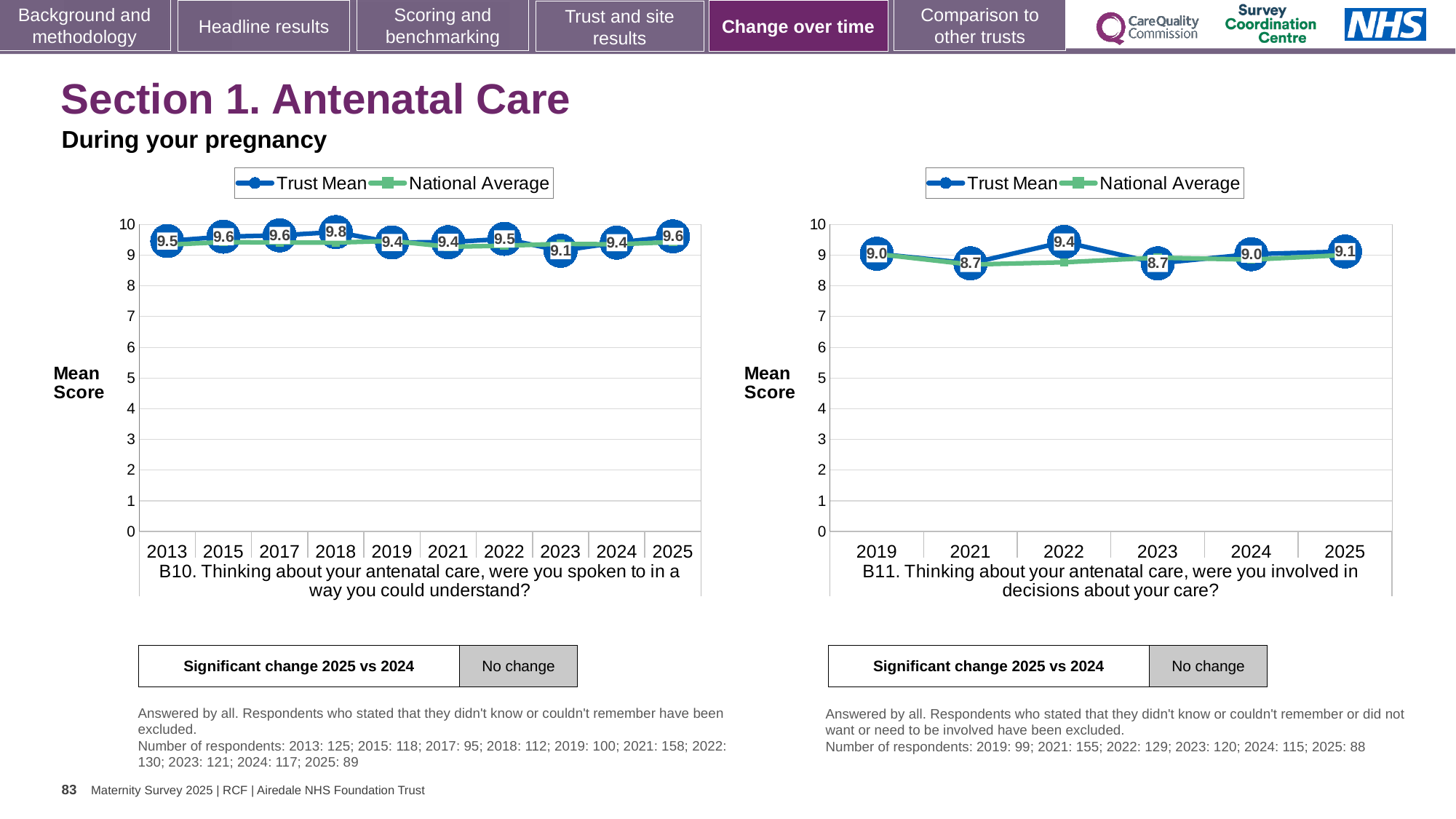
In the right chart (B11), is the Trust Mean for 2024 or 2025 larger? 2025 In the left chart (B10), what is the difference between the Trust Mean for 2018 and 2023? 0.7 In the right chart (B11), how many series does the legend list? 2 In the left chart (B10), what is the Trust Mean for 2023? 9.1 In the right chart (B11), what is the Trust Mean for 2025? 9.1 In the left chart (B10), what is the Trust Mean for 2018? 9.8 In the right chart (B11), which year has the highest Trust Mean? 2022 In the left chart (B10), how many years are shown on the x axis? 10 What type of chart is the left chart (B10)? Line chart In the left chart (B10), which year has the highest Trust Mean? 2018 In the left chart (B10), which year has the lowest Trust Mean? 2023 In the right chart (B11), what is the Trust Mean for 2022? 9.4